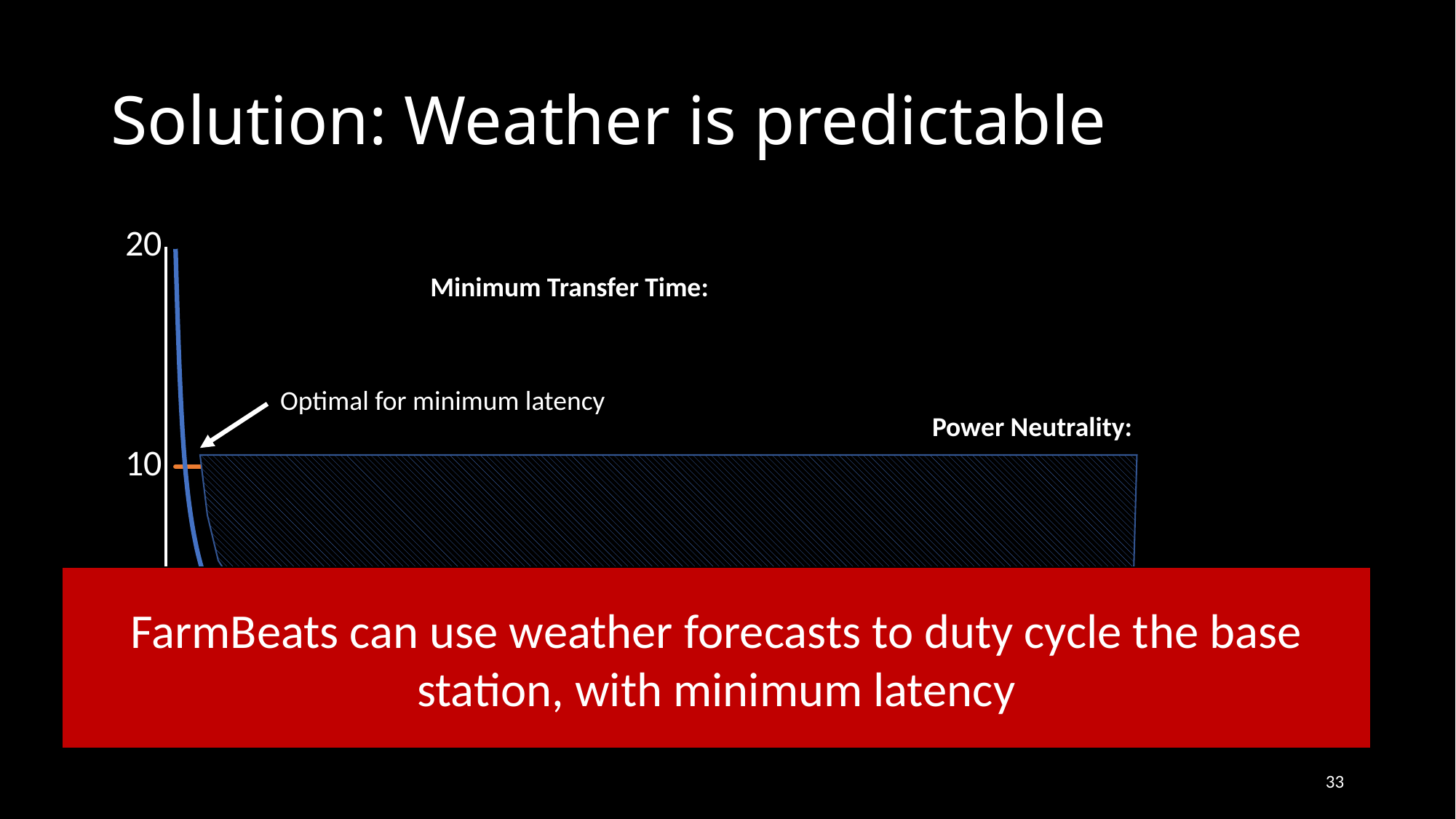
Is the value of the blue curve at its leftmost visible point greater or less than 10? greater What is the highest value labelled on the y axis of the chart? 20 Does the blue curve rise or fall as it moves to the right along the x axis? fall At which y-axis tick value is the point labelled 'Optimal for minimum latency' marked? 10 What kind of chart is shown on the slide? line chart What colour is the curve plotted on the chart? blue